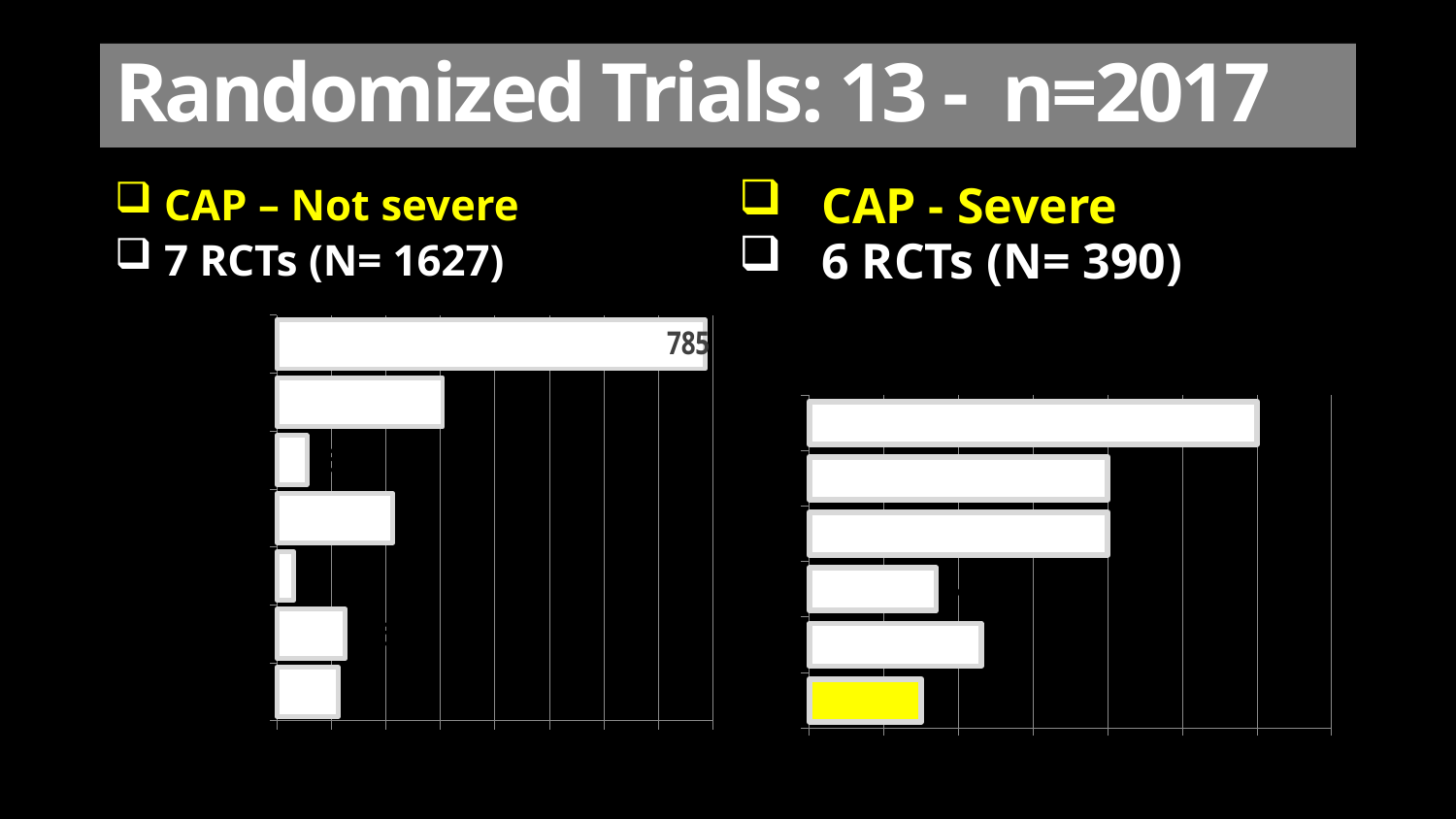
In the right chart (CAP - Severe), how many bars are plotted? 6 What kind of chart is shown on the right side of the slide, under 'CAP - Severe'? bar chart In the right chart (CAP - Severe), what colour is the bottom bar? yellow In the left chart (CAP – Not severe), which bar is the shortest? the fifth bar from the top In the right chart (CAP - Severe), which bar is the longest? the top bar In the left chart (CAP – Not severe), which bar is the longest? the top bar What kind of chart is shown on the left side of the slide, under 'CAP – Not severe'? bar chart In the left chart (CAP – Not severe), how many bars are plotted? 7 In the left chart (CAP – Not severe), what value is printed on the top bar? 785 In the right chart (CAP - Severe), which is longer: the fourth bar from the top or the fifth bar from the top? the fifth bar from the top In the right chart (CAP - Severe), which bar is the shortest? the bottom bar In the left chart (CAP – Not severe), which is longer: the top bar or the second bar from the top? the top bar